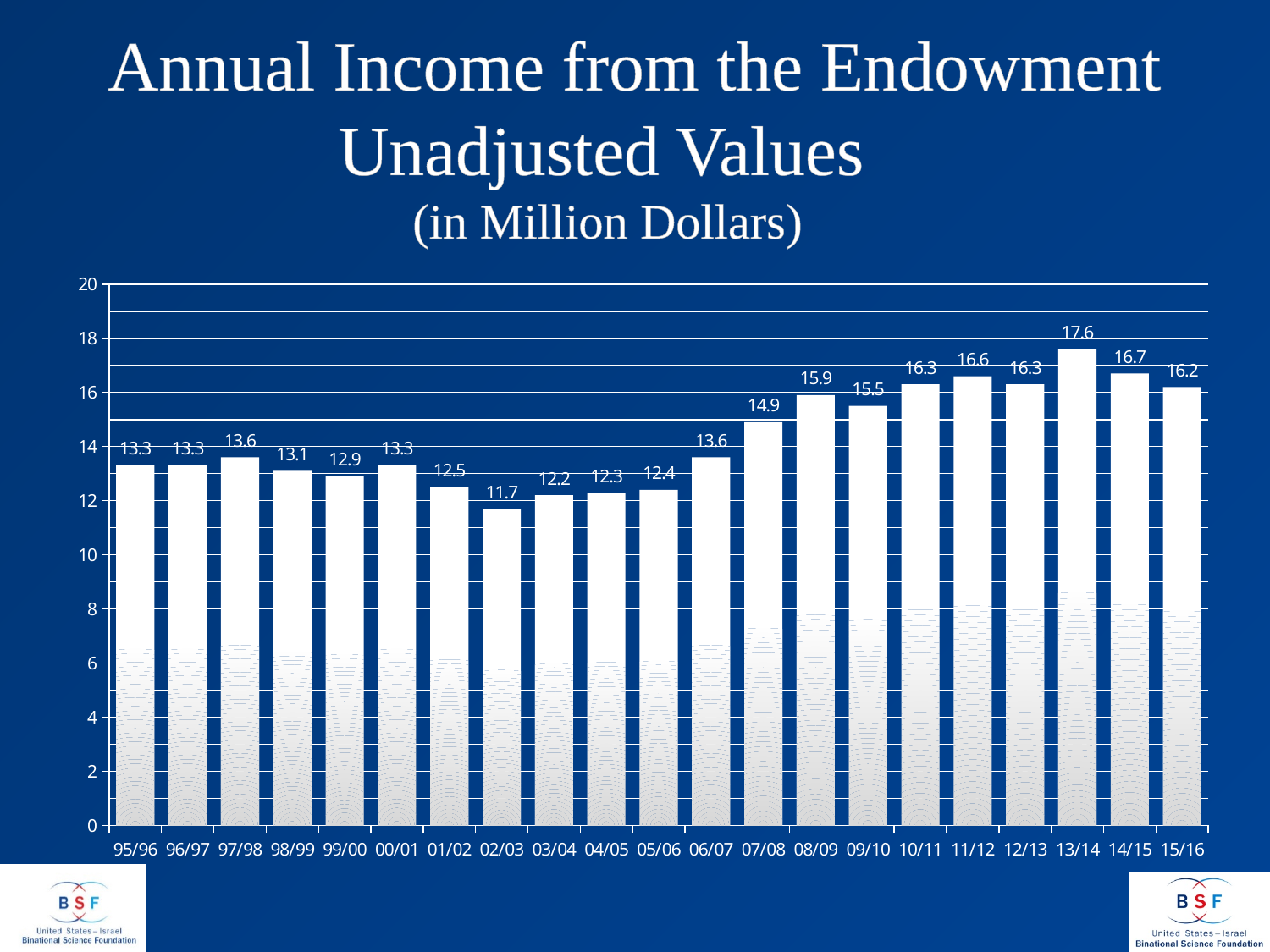
What kind of chart is shown on the slide? Bar chart What is the value shown for 02/03? 11.7 What is the difference between the values for 15/16 and 14/15? 0.5 What is the annual income from the endowment for 13/14? 17.6 Which year has the highest annual income from the endowment? 13/14 How many years are shown on the x axis? 21 What is the difference between the values for 13/14 and 02/03? 5.9 Which year has the lowest annual income from the endowment? 02/03 What unit is stated in the chart title for the values? Million Dollars What is the value shown for 07/08? 14.9 Is the value for 11/12 greater or less than 16? greater Which is larger, the value for 08/09 or the value for 09/10? 08/09